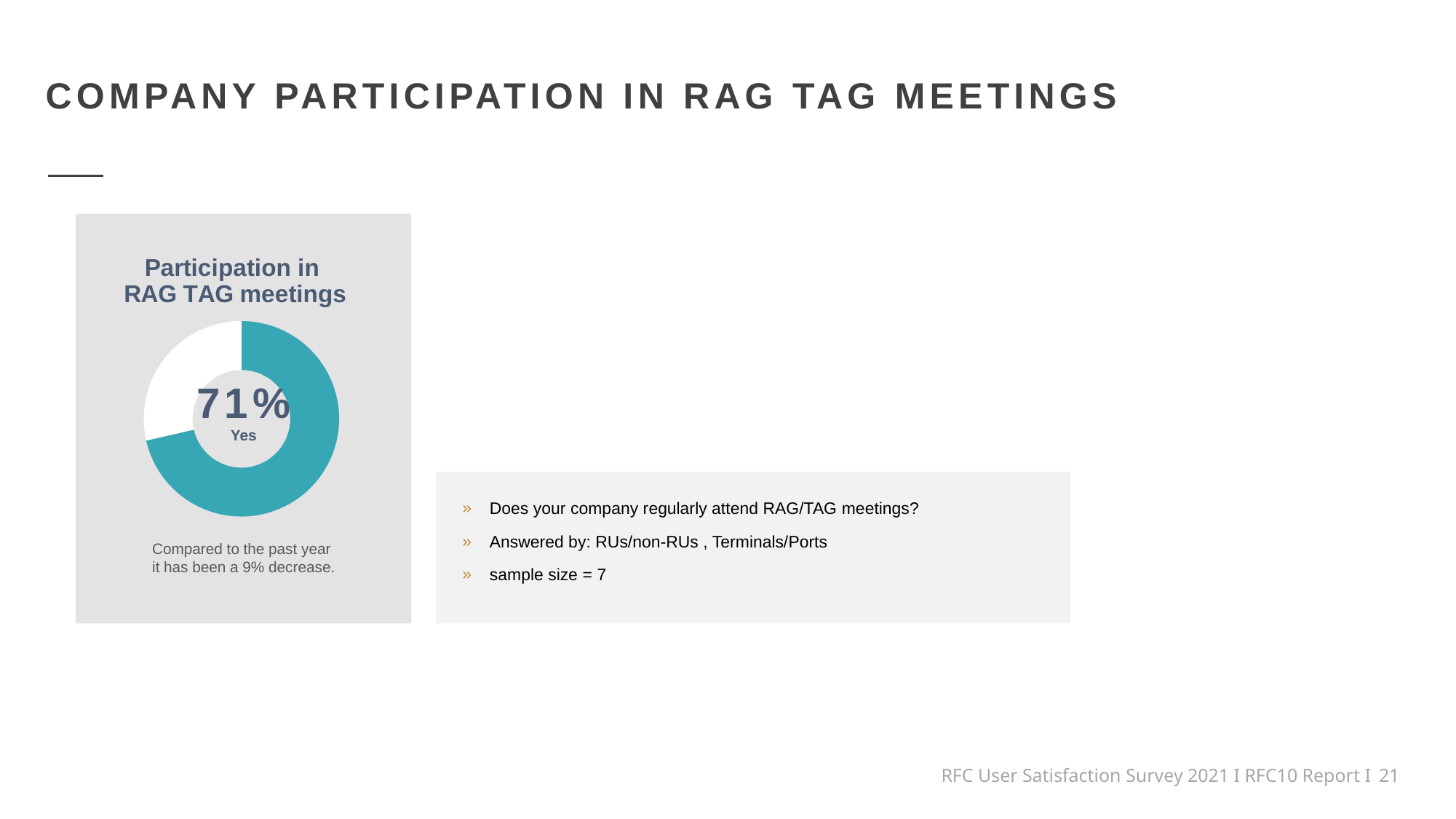
Which response is labelled in the centre of the donut chart? Yes Is the Yes share in the Participation in RAG TAG meetings chart greater or less than 50%? greater Which segment of the donut chart is larger, the Yes segment or the remaining segment? Yes What kind of chart is used to show participation in RAG TAG meetings? pie chart (donut) How many segments does the donut chart have? 2 What is the title of the chart on the slide? Participation in RAG TAG meetings What colour is the Yes segment of the donut chart? teal What percentage of companies answered Yes in the Participation in RAG TAG meetings chart? 71%